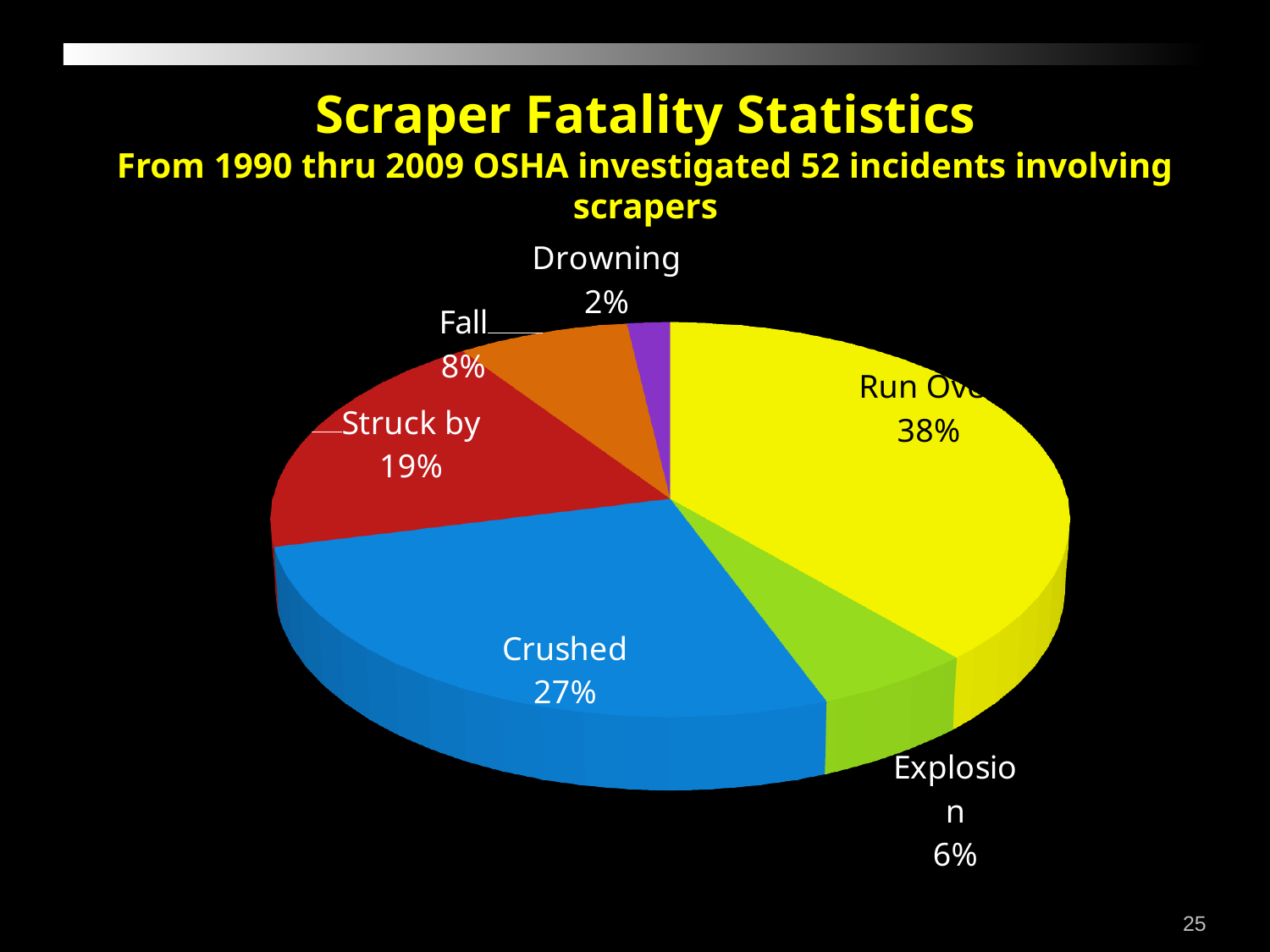
What percentage is shown for Drowning? 2% Which category has the smallest slice of the pie? Drowning What is the difference in percentage points between Run Over and Crushed? 11 What percentage of scraper fatalities is attributed to Run Over? 38% How many categories are shown in the pie chart? 6 What percentage is shown for Fall? 8% What percentage is shown for Explosion? 6% What kind of chart is shown on the slide? pie chart Which is larger, Struck by or Fall? Struck by What share of the pie does Crushed represent? 27% What is the value for Struck by? 19% Which category has the largest slice of the pie? Run Over